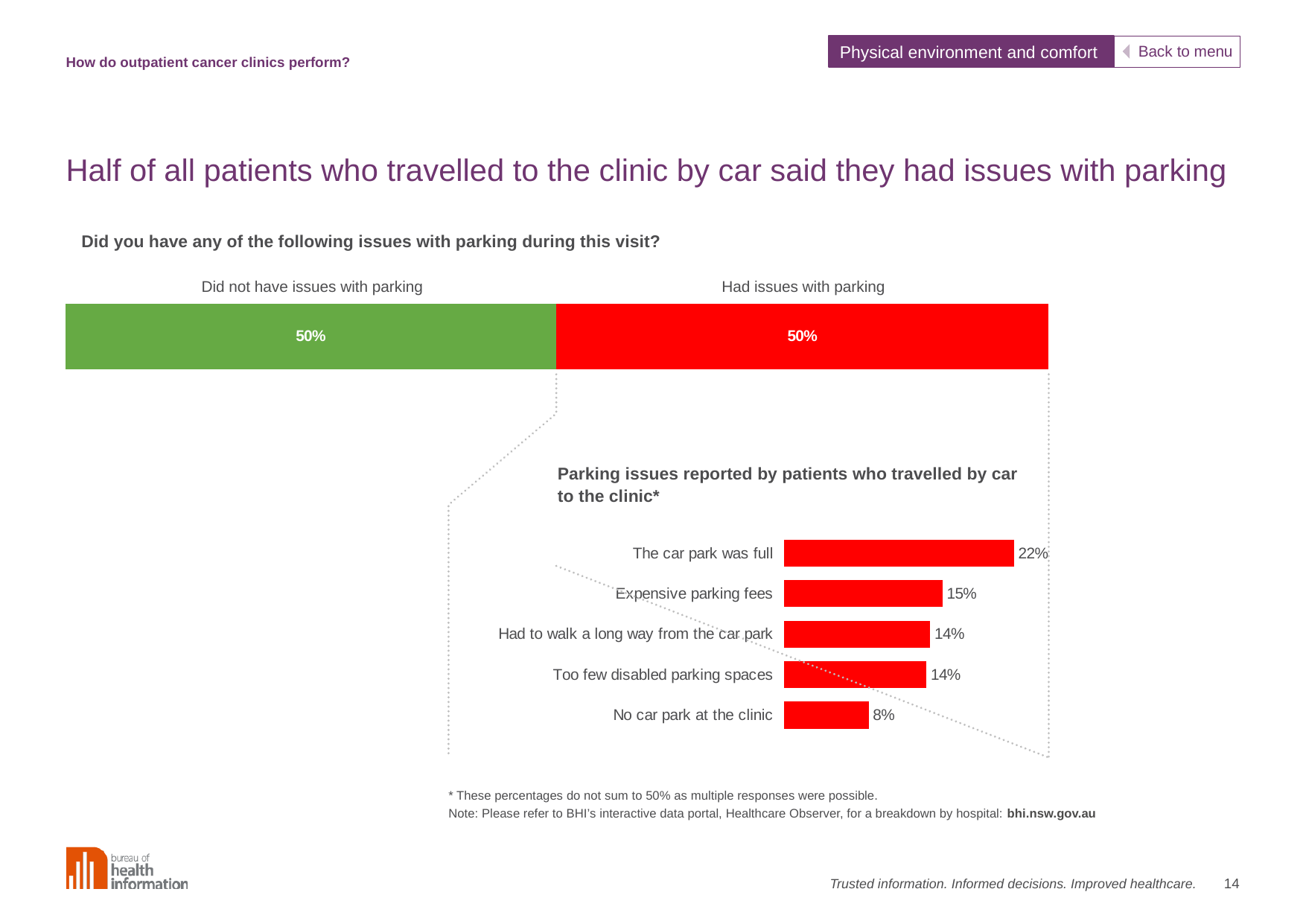
In the 'Parking issues reported by patients who travelled by car to the clinic' chart, what percentage reported expensive parking fees? 15% How many parking issues are listed in the 'Parking issues reported by patients who travelled by car to the clinic' chart? 5 In the 'Parking issues reported by patients who travelled by car to the clinic' chart, which parking issue was reported by the lowest percentage of patients? No car park at the clinic In the top bar chart under 'Did you have any of the following issues with parking during this visit?', what colour is the 'Had issues with parking' segment? Red What kind of chart is the 'Parking issues reported by patients who travelled by car to the clinic' chart? Bar chart In the 'Parking issues reported by patients who travelled by car to the clinic' chart, what percentage said there was no car park at the clinic? 8% In the 'Parking issues reported by patients who travelled by car to the clinic' chart, what is the difference in percentage points between 'The car park was full' and 'No car park at the clinic'? 14 percentage points In the top bar chart under 'Did you have any of the following issues with parking during this visit?', what percentage of patients did not have issues with parking? 50% In the 'Parking issues reported by patients who travelled by car to the clinic' chart, what percentage of patients said the car park was full? 22% In the 'Parking issues reported by patients who travelled by car to the clinic' chart, which is larger: the value for 'Expensive parking fees' or 'Too few disabled parking spaces'? Expensive parking fees In the 'Parking issues reported by patients who travelled by car to the clinic' chart, which parking issue was reported by the highest percentage of patients? The car park was full In the top bar chart under 'Did you have any of the following issues with parking during this visit?', what percentage of patients had issues with parking? 50%